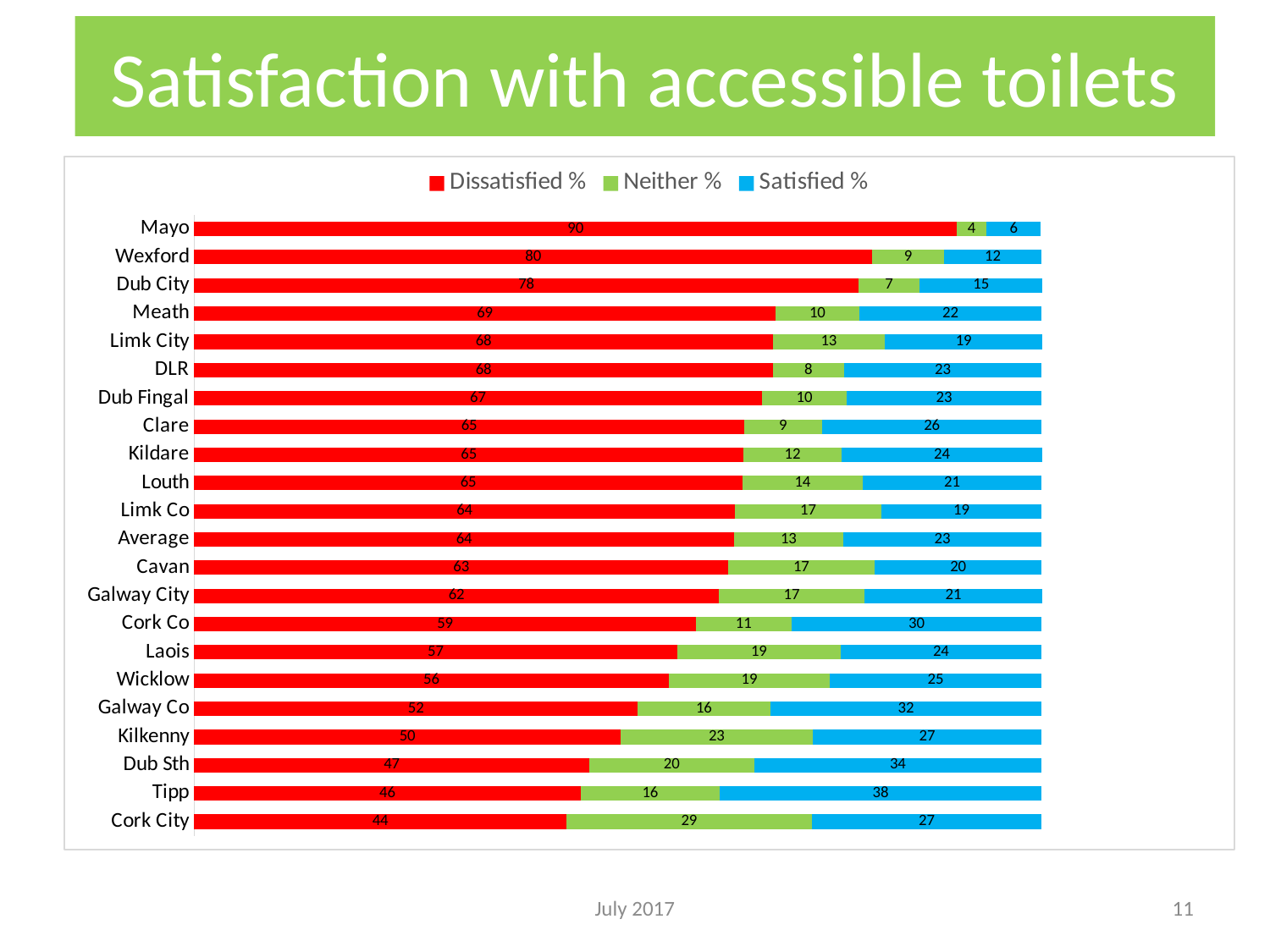
What is the title of the chart on the slide? Satisfaction with accessible toilets What is the Neither % value for Kilkenny? 23 What kind of chart is shown on the slide? Stacked bar chart Which category has the highest Dissatisfied % value? Mayo What is the Satisfied % value for Cork Co? 30 Which category has the highest Satisfied % value? Tipp What is the difference between the Dissatisfied % values for Mayo and Cork City? 46 Which has a larger Satisfied % value, Galway Co or Dub Sth? Dub Sth How many series does the legend list? 3 How many categories are shown on the chart? 22 What is the Dissatisfied % value for Wexford? 80 Which category has the lowest Dissatisfied % value? Cork City